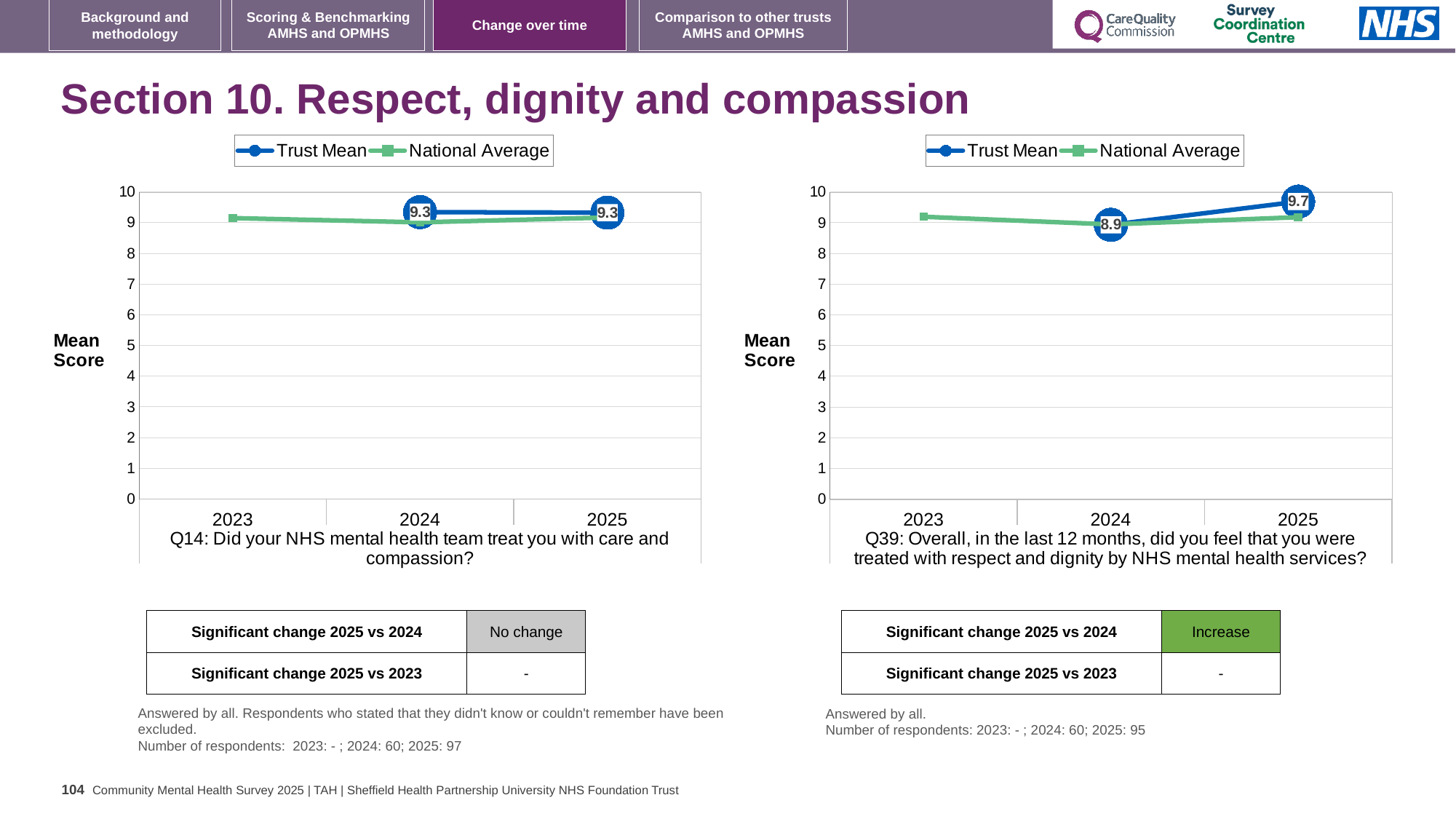
What is the label of the y axis on the right chart (Q39)? Mean Score In the right chart (Q39), what is the difference between the Trust Mean for 2025 and the Trust Mean for 2024? 0.8 In the left chart (Q14), what is the Trust Mean for 2025? 9.3 How many series does the legend of the left chart (Q14) list? 2 What kind of chart is the left chart (Q14)? line chart In the right chart (Q39), what is the Trust Mean for 2025? 9.7 How many years are shown on the x axis of the right chart (Q39)? 3 In the right chart (Q39), which year has the higher Trust Mean, 2024 or 2025? 2025 In the right chart (Q39), does the Trust Mean rise or fall from 2024 to 2025? rise In the right chart (Q39), what is the Trust Mean for 2024? 8.9 In the left chart (Q14), what is the Trust Mean for 2024? 9.3 In the left chart (Q14), is the National Average for 2023 greater or less than 8? greater